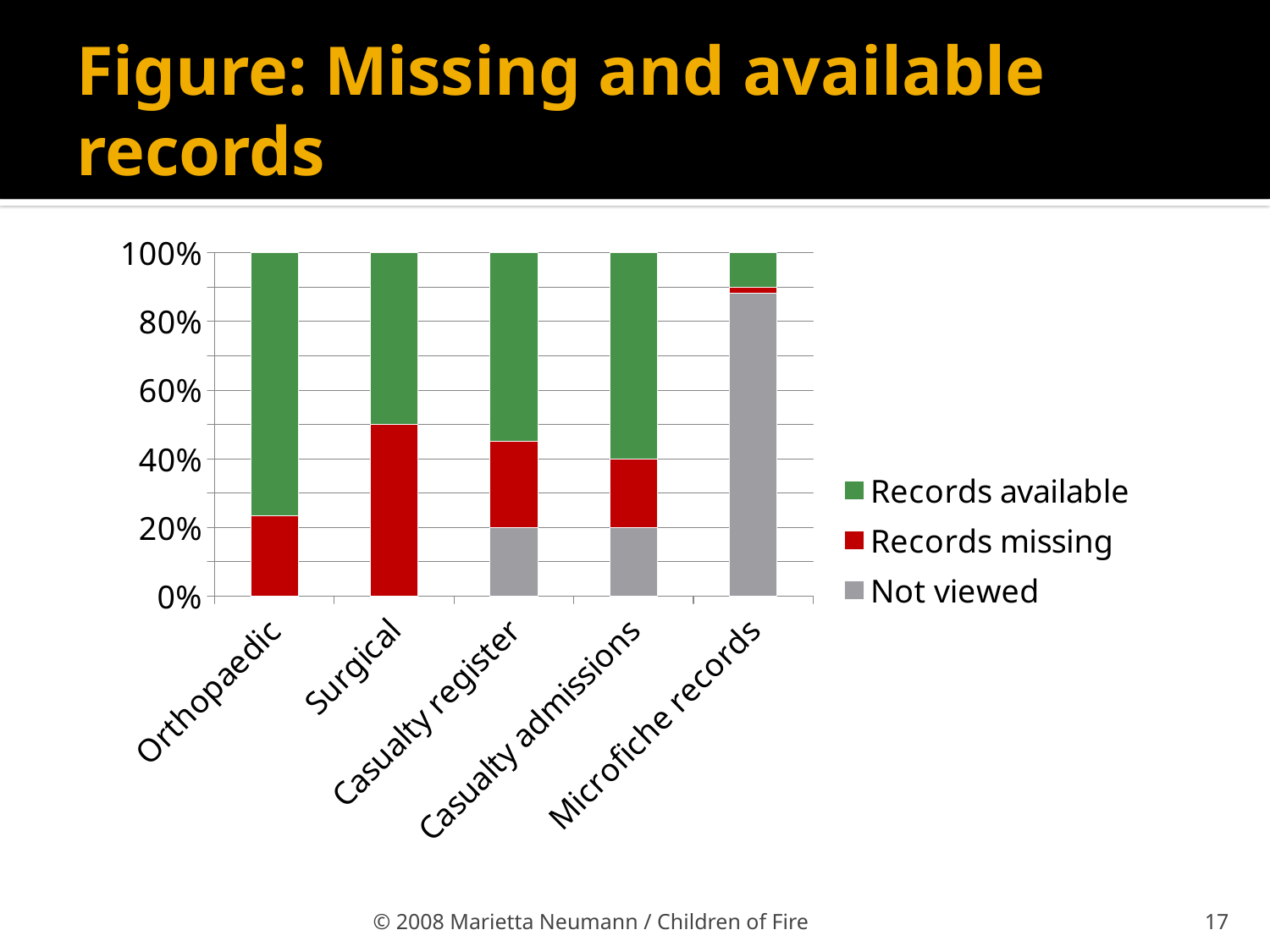
What is the total height of the stacked bar for Orthopaedic? 100% Which category has the smallest Records available segment? Microfiche records How many categories are shown on the x axis of the chart? 5 What kind of chart is shown on the slide? Stacked bar chart Which category has the largest Not viewed segment? Microfiche records Which category has the largest Records available segment? Orthopaedic Is the Not viewed segment for Microfiche records greater or less than 80%? greater Which colour represents the Not viewed series in the legend? Grey How many series does the chart's legend list? 3 Is the Records missing segment larger for Surgical or for Casualty admissions? Surgical Which category has the largest Records missing segment? Surgical Is the Records available segment for Surgical greater or less than 60%? less